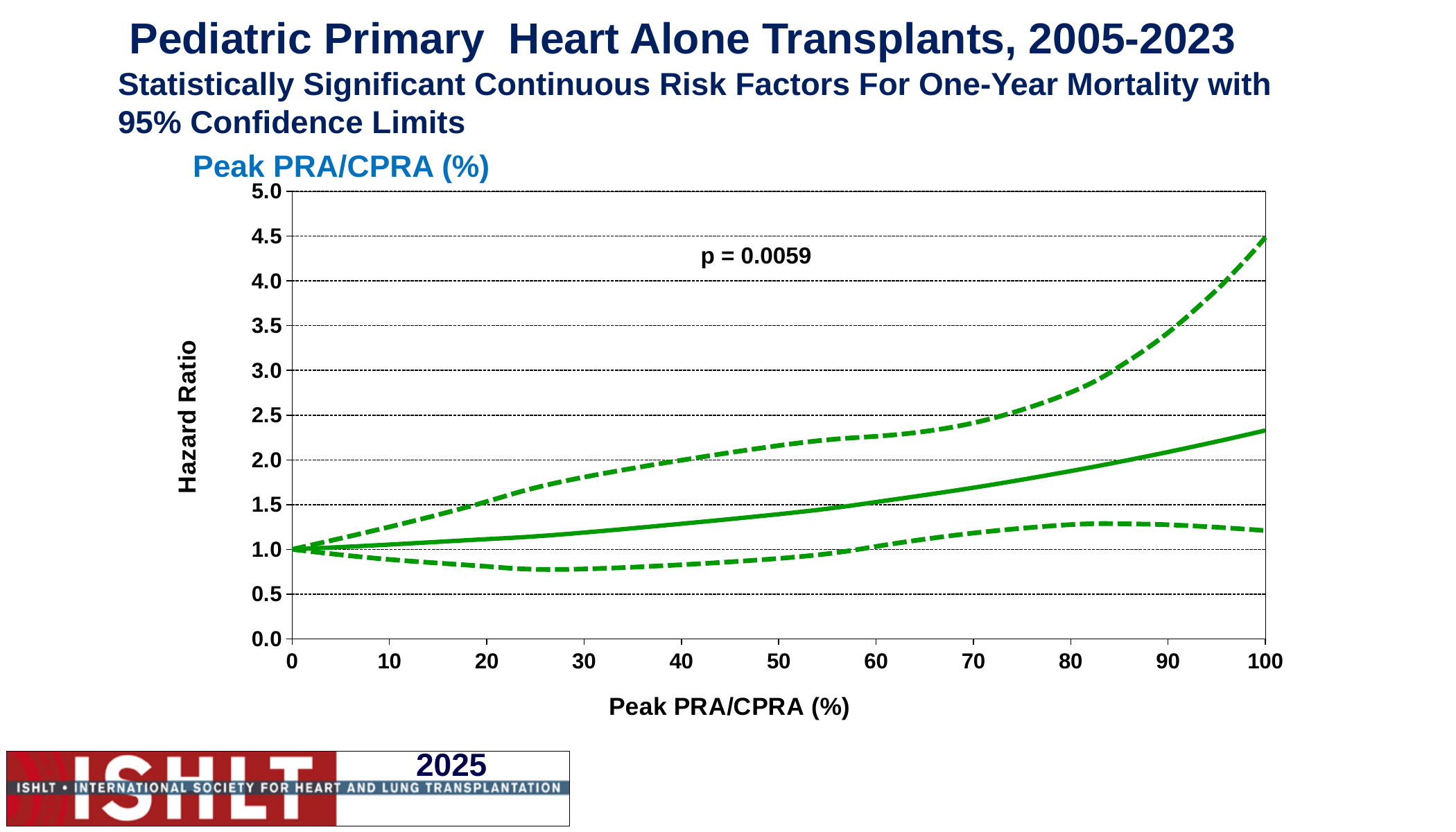
Is the hazard ratio of the solid line at a Peak PRA/CPRA of 50% greater or less than 1.5? less Is the lower dashed confidence limit at a Peak PRA/CPRA of 30% greater or less than 1.0? less What is the title of the chart? Peak PRA/CPRA (%) Is the hazard ratio of the solid line at a Peak PRA/CPRA of 100% greater or less than 2.0? greater What is the label of the y axis? Hazard Ratio What kind of chart is shown on the slide? line chart What is the hazard ratio of the solid line at a Peak PRA/CPRA of 0%? 1.0 What p-value is printed on the chart? p = 0.0059 At what Peak PRA/CPRA value does the solid hazard ratio line reach its highest point? 100 How many lines are plotted on the chart? 3 Does the solid hazard ratio line rise or fall as Peak PRA/CPRA increases from 0 to 100? rise